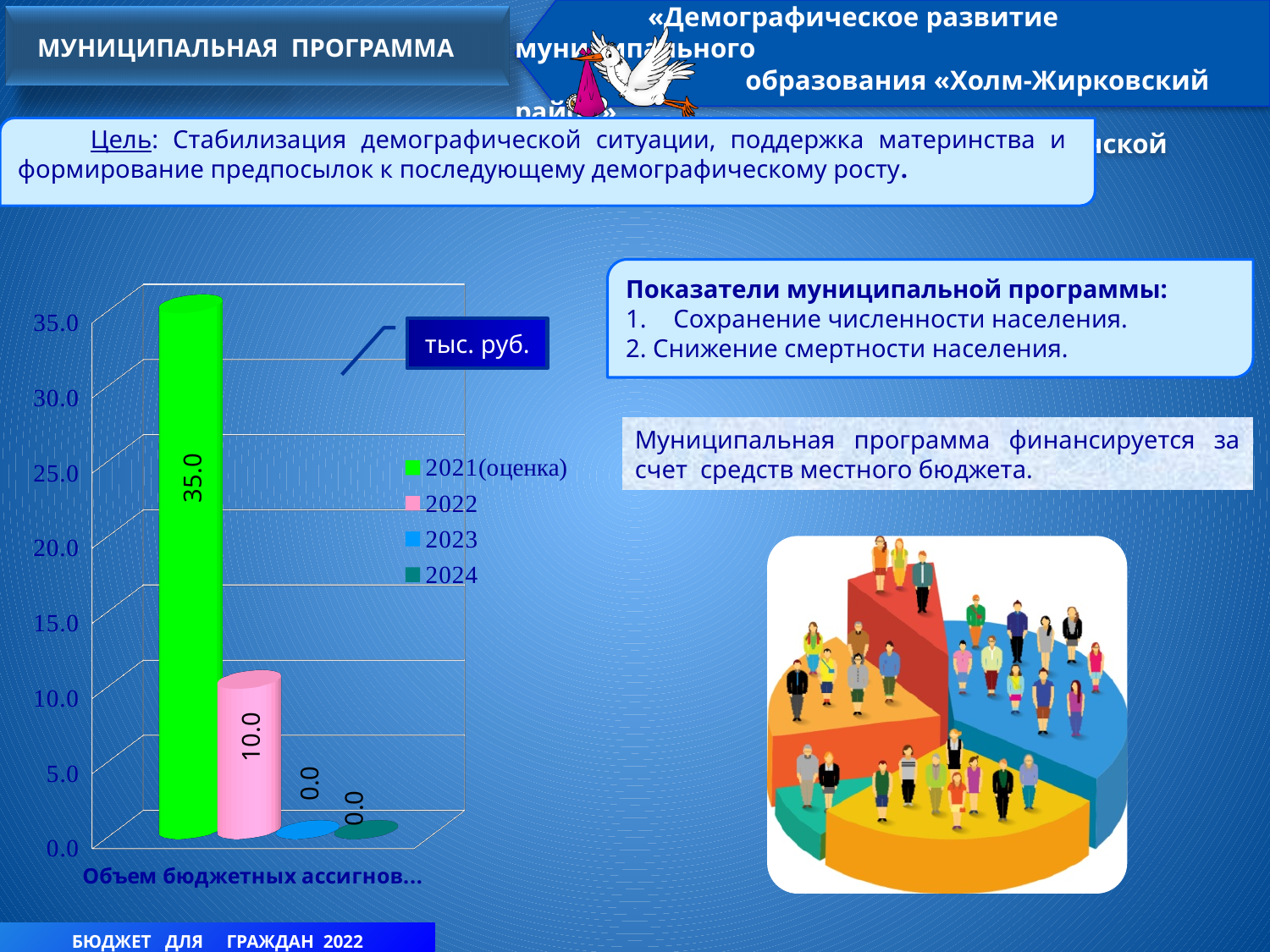
Do the values fall or rise from 2021(оценка) to 2024 in the chart? fall Is the value for 2022 greater or less than 15.0? less What is the value for the 2024 series in the chart? 0.0 How many series does the chart legend list? 4 What kind of chart is shown on the slide? bar chart Which is larger, the value for 2021(оценка) or the value for 2022? 2021(оценка) What is the value for the 2023 series in the chart? 0.0 What unit is shown in the label box next to the chart? тыс. руб. What is the difference between the 2021(оценка) value and the 2022 value? 25.0 What is the value for the 2021(оценка) series in the chart? 35.0 Which series has the highest value in the chart? 2021(оценка) What is the value for the 2022 series in the chart? 10.0